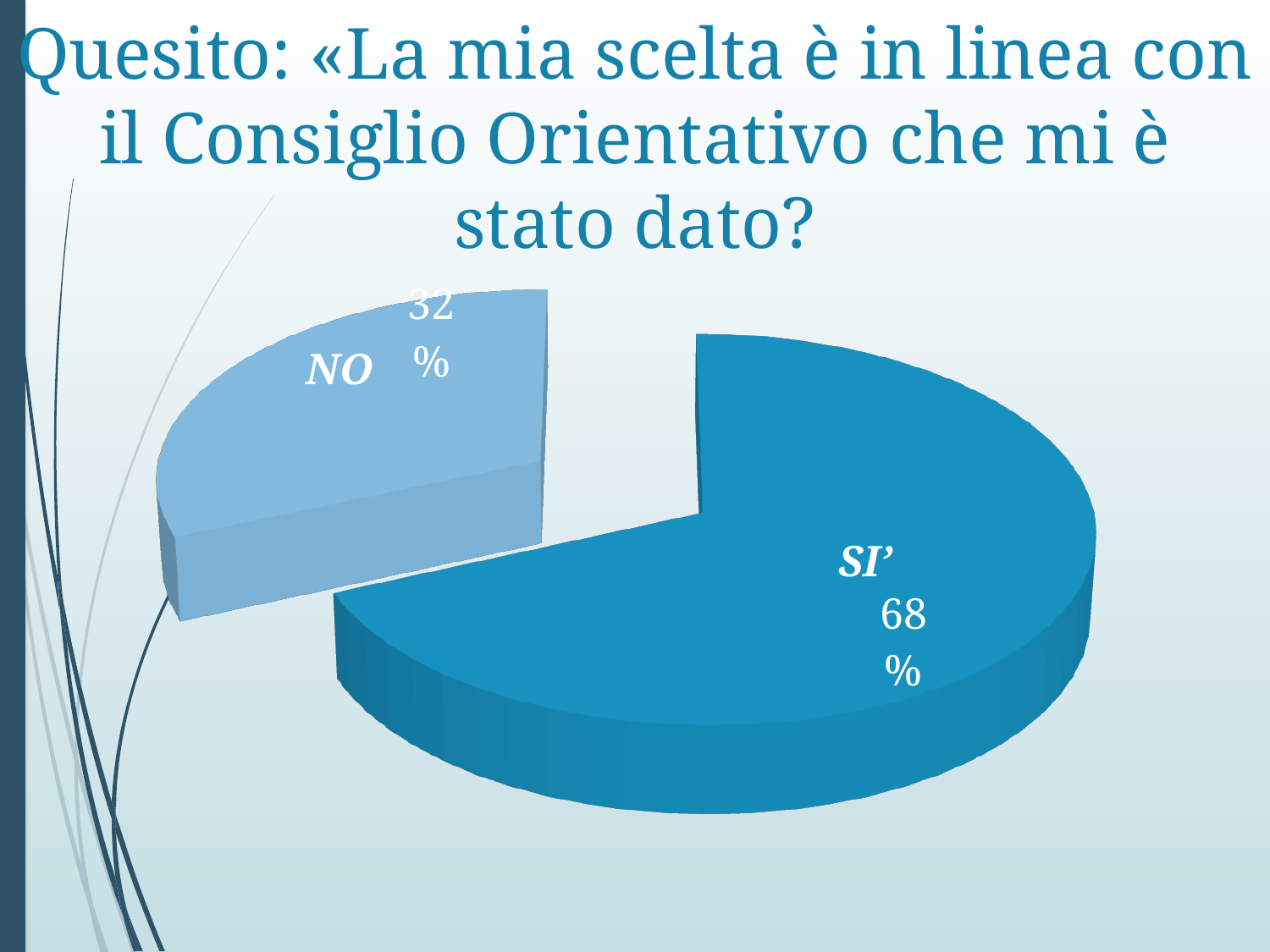
What question does the slide title say the chart is about? «La mia scelta è in linea con il Consiglio Orientativo che mi è stato dato?» What percentage of respondents answered SI'? 68% What percentage of respondents answered NO? 32% Which response has the largest share of the pie? SI' What is the difference in percentage points between the SI' and NO slices? 36 Which slice is larger, SI' or NO? SI' Is the share for SI' greater or less than 50%? greater What kind of chart is shown on the slide? Pie chart Which slice is shown in the lighter blue colour? NO How many slices does the pie chart have? 2 What share of the pie does the NO slice represent? 32% Which response has the smallest share of the pie? NO